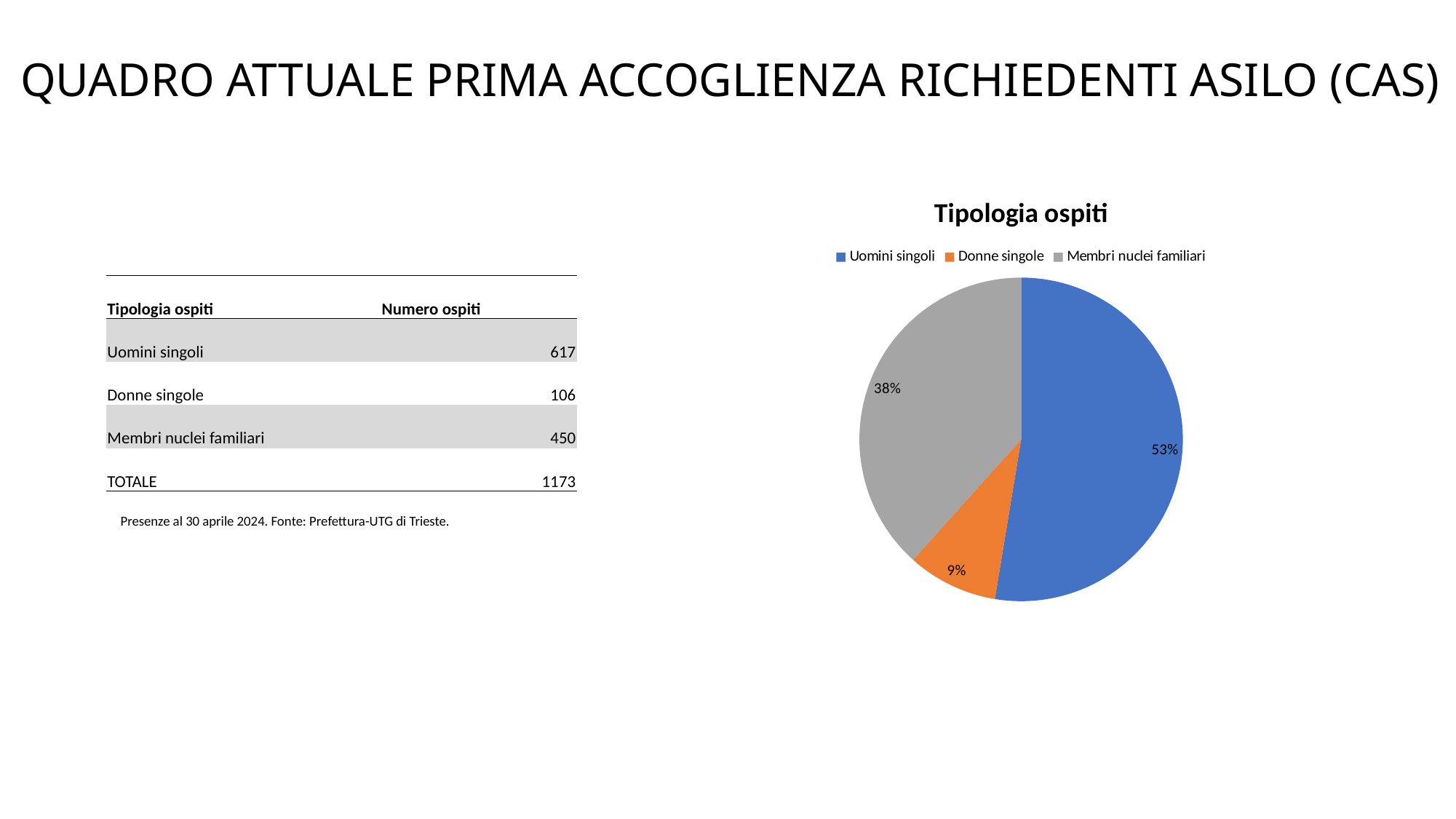
By how many percentage points does the Uomini singoli share exceed the Membri nuclei familiari share? 15 Which colour represents Donne singole in the pie chart? orange What share of the pie does Uomini singoli represent? 53% Which category has the largest slice of the pie? Uomini singoli What is the title of the chart? Tipologia ospiti Which category has the smallest slice of the pie? Donne singole How many slices does the pie chart have? 3 How many entries does the chart legend list? 3 What share of the pie does Membri nuclei familiari represent? 38% Which slice is larger, Membri nuclei familiari or Donne singole? Membri nuclei familiari What type of chart is shown on the slide? pie chart What share of the pie does Donne singole represent? 9%